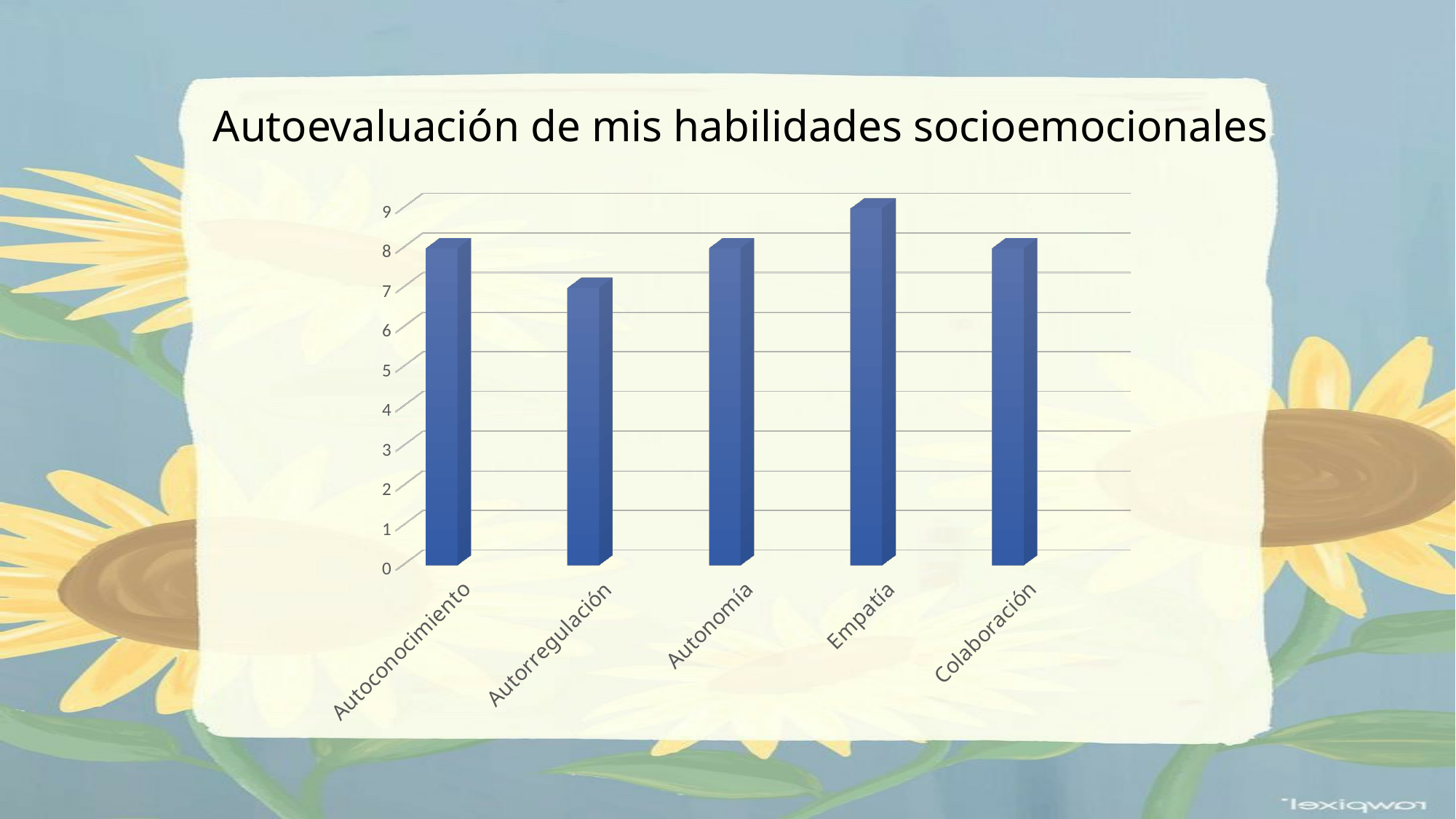
How many categories are plotted in the chart? 5 Is the value for Autonomía greater or less than 5? greater What is the value for Empatía? 9 What kind of chart is shown on the slide? bar chart Which is larger, the value for Empatía or the value for Colaboración? Empatía Which category has the lowest value? Autorregulación What is the value for Autoconocimiento? 8 What is the value for Autorregulación? 7 What is the title of the chart? Autoevaluación de mis habilidades socioemocionales Which category has the highest value? Empatía What is the difference between the values for Empatía and Autorregulación? 2 Is the value for Autorregulación greater or less than 8? less